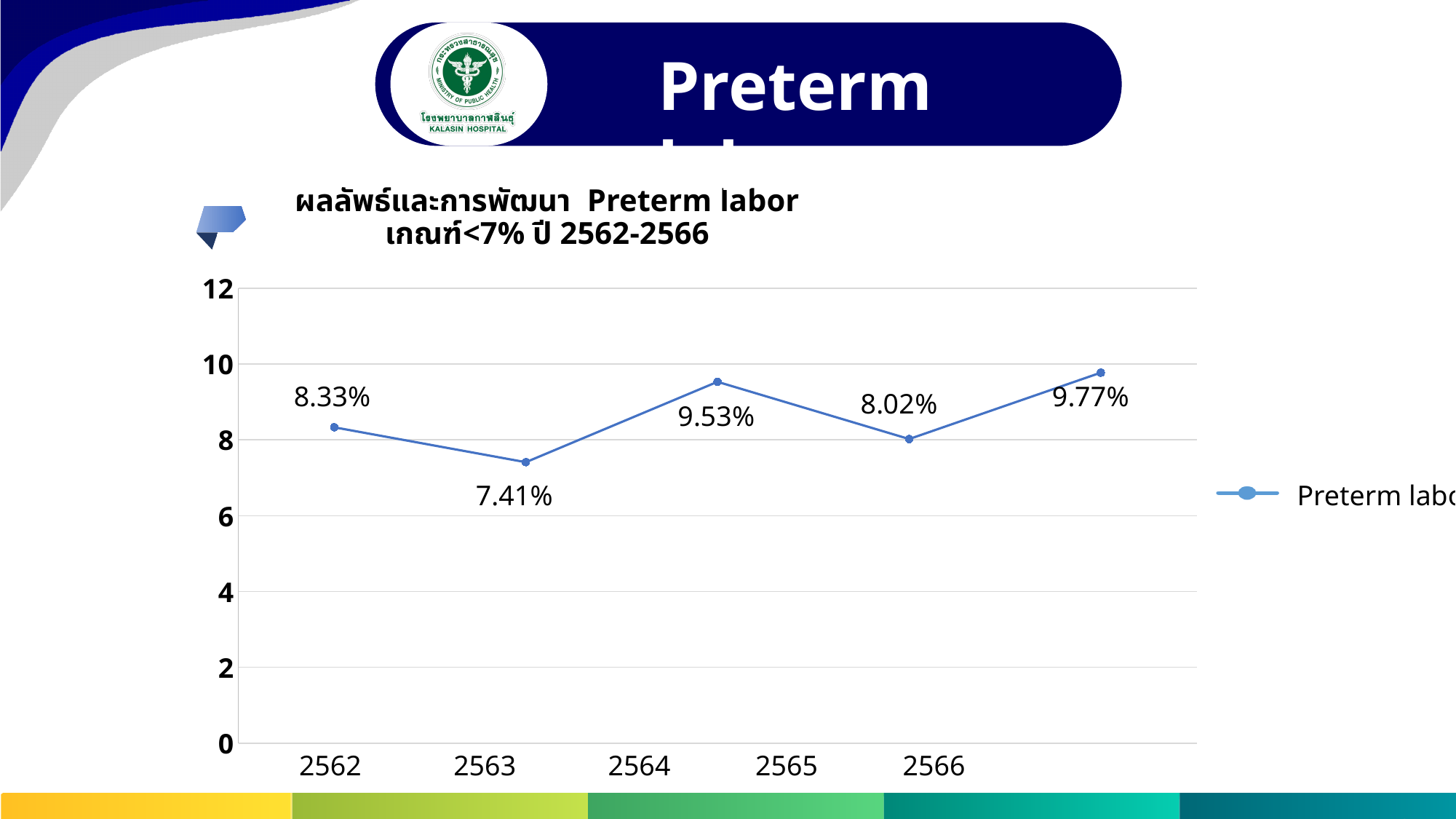
What is the Preterm labor value for 2565? 8.02% What is the Preterm labor value for 2562? 8.33% Which year has the lowest Preterm labor value? 2563 What type of chart is shown on the slide? line chart Which year has a larger Preterm labor value, 2564 or 2565? 2564 Does the Preterm labor value rise or fall from 2565 to 2566? rise What is the Preterm labor value for 2563? 7.41% How many years are plotted on the chart? 5 Is the Preterm labor value for 2563 greater or less than 8? less What is the difference between the Preterm labor values for 2566 and 2563? 2.36% Which year has the highest Preterm labor value? 2566 What is the target criterion for Preterm labor stated in the chart title? <7%